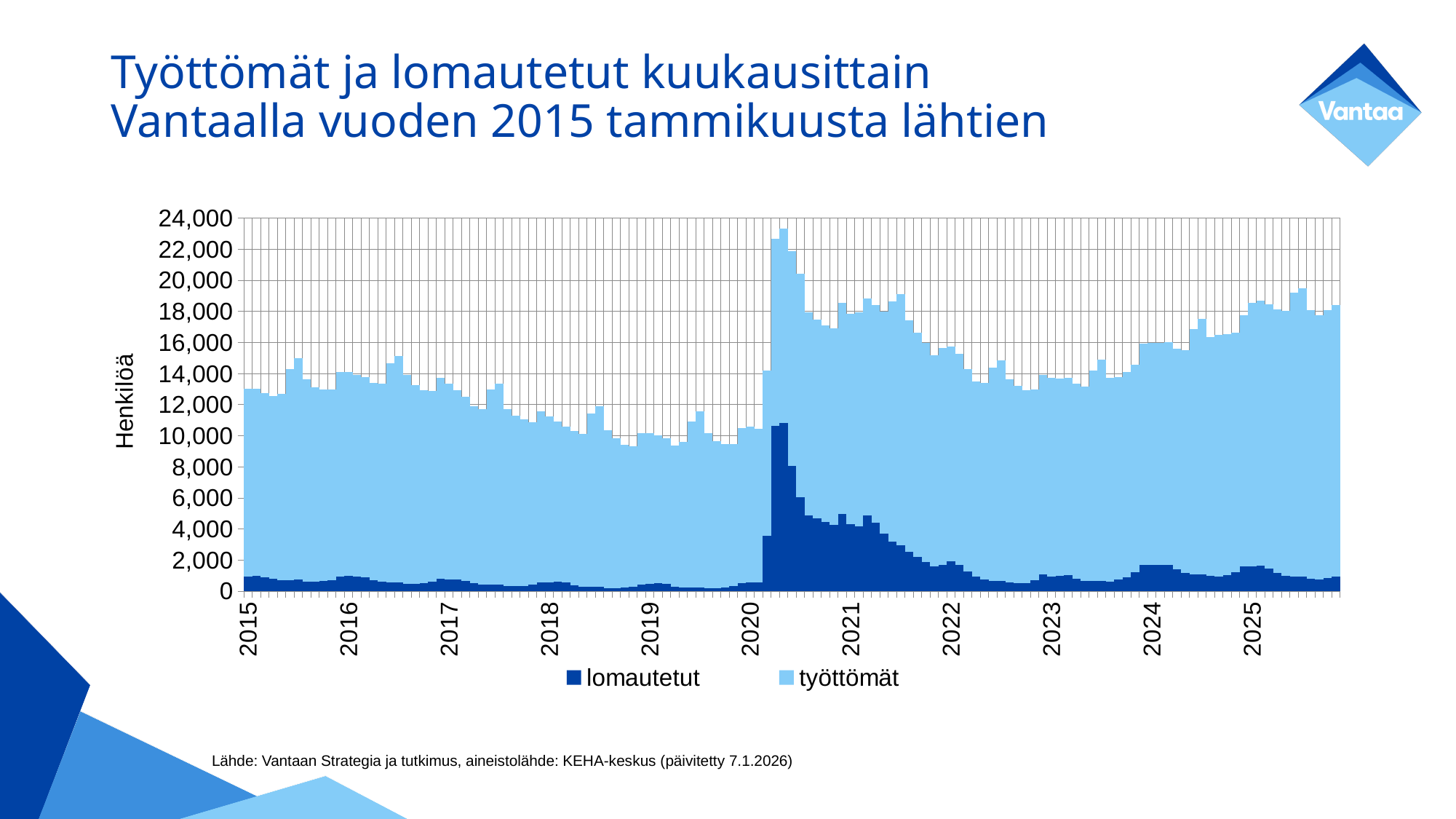
Is the stacked total at the end of 2025 greater or less than 16,000? greater What kind of chart is shown on the slide? Stacked bar chart What is the label on the vertical axis of the chart? Henkilöä Which is larger, the lomautetut value in 2020 or the lomautetut value in 2018? 2020 Is the value of lomautetut during 2018 greater or less than 2,000? less Is the stacked total at the start of 2015 greater or less than 12,000? greater Does the stacked total rise or fall from 2015 to 2019? fall What are the two series named in the legend? lomautetut and työttömät In which year does the total of työttömät and lomautetut reach its highest peak? 2020 How many series does the legend list? 2